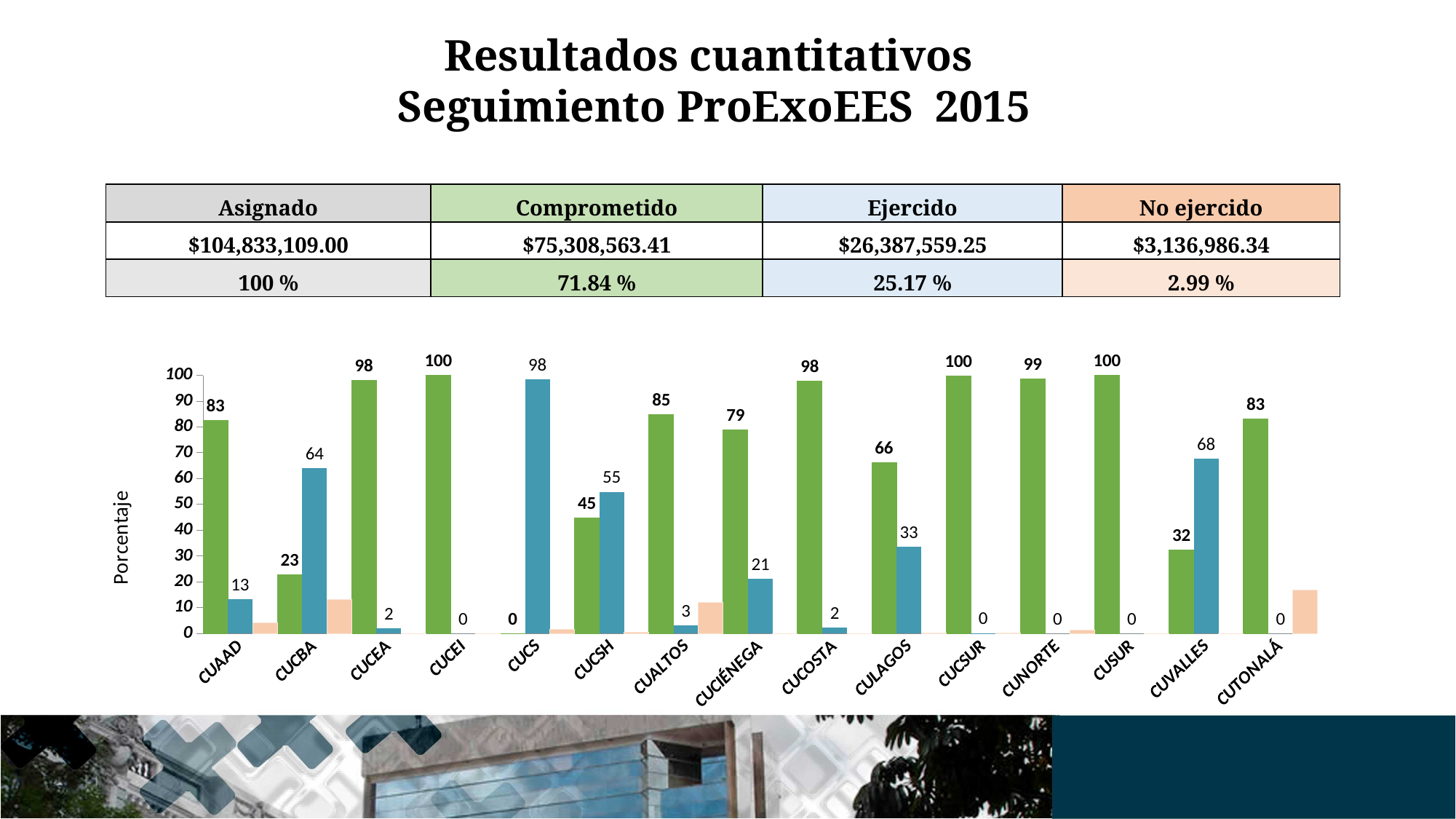
What is the label of the vertical axis of the chart? Porcentaje What is the value of the blue bar for CUVALLES? 68 What is the difference between the green bar and the blue bar for CUAAD? 70 How many categories are shown on the x axis of the chart? 15 What is the value of the green bar for CUCBA? 23 What kind of chart is shown on the slide? bar chart What is the value of the blue bar for CUCIÉNEGA? 21 Which category has the lowest green bar? CUCS What is the difference between the blue bar and the green bar for CUCSH? 10 For CUCBA, which is larger, the green bar or the blue bar? the blue bar Which category has the highest blue bar? CUCS Is the value of the orange bar for CUALTOS greater or less than 20? less